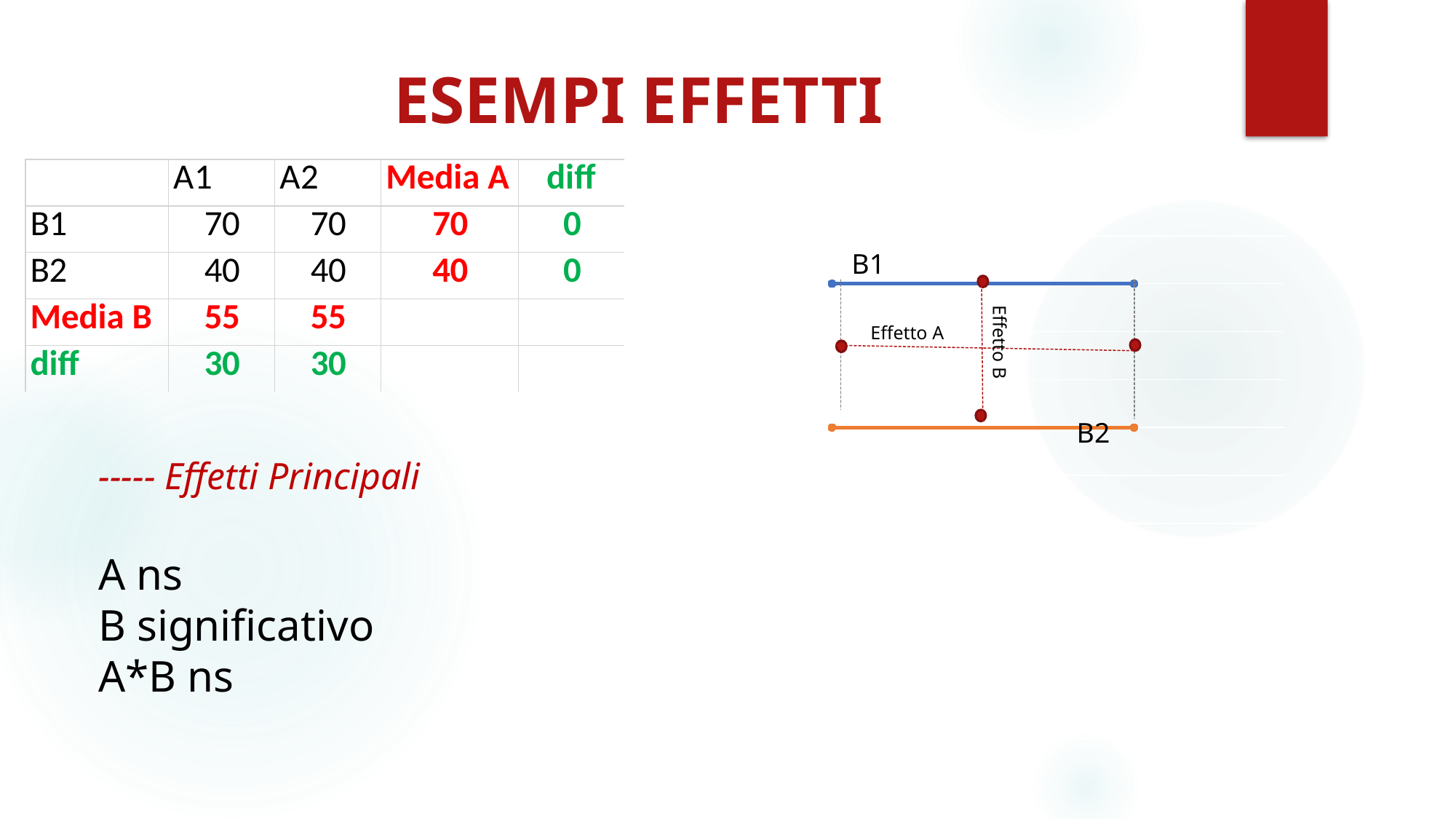
What are the labels of the two lines in the chart on the right? B1 and B2 In the chart on the right, what is the label on the horizontal dashed red line? Effetto A How many lines are plotted in the chart on the right? 2 What kind of chart is shown on the right of the slide? line chart In the chart on the right, does the B2 line rise, fall or stay flat from left to right? stays flat In the chart on the right, which line is plotted higher, B1 or B2? B1 In the chart on the right, which line is the lowest? B2 In the chart on the right, what is the label on the vertical dashed red line? Effetto B In the chart on the right, does the B1 line rise, fall or stay flat from left to right? stays flat